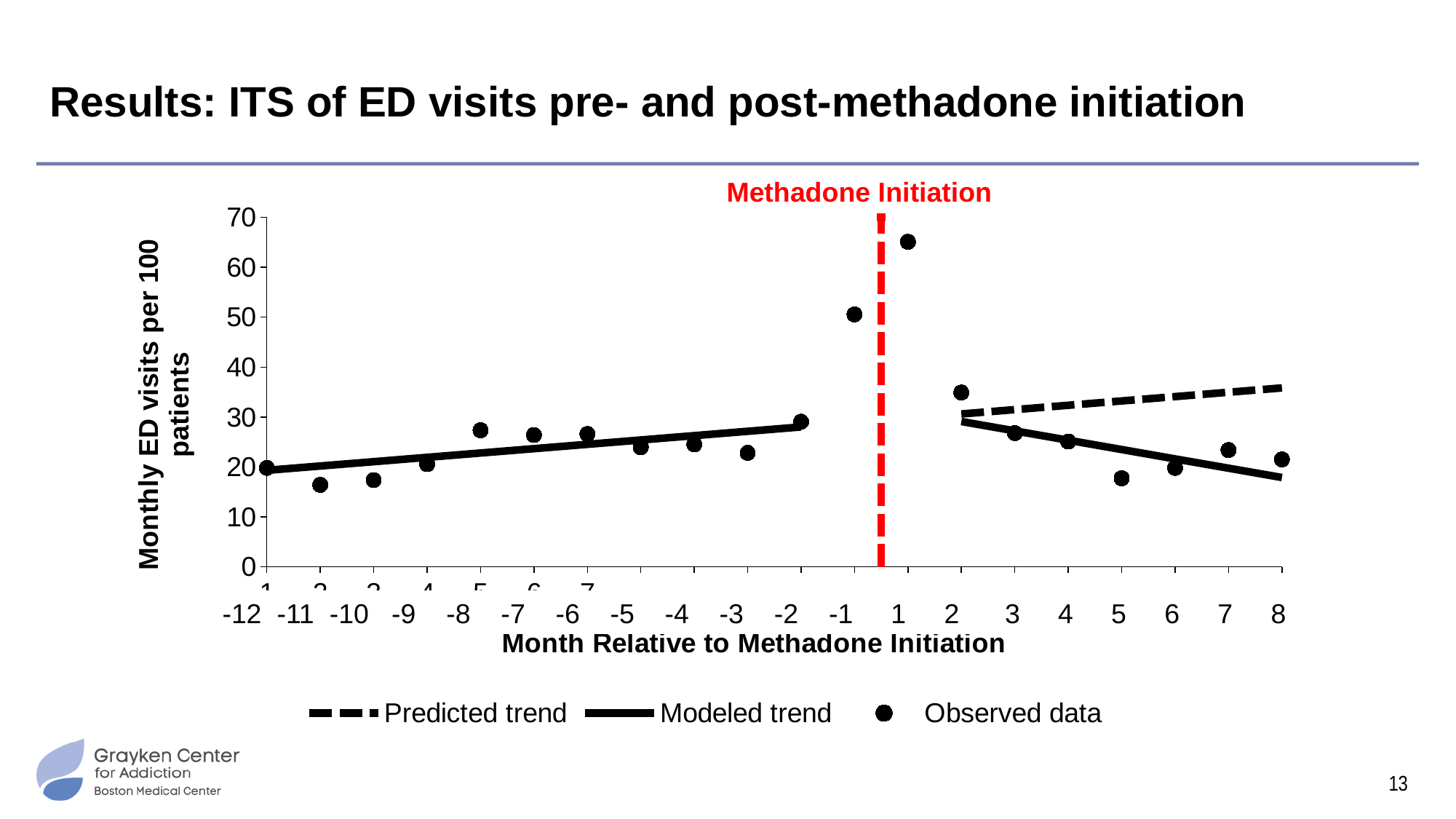
Is the observed value for month 2 greater or less than 30? greater How many entries does the legend list? 3 Is the observed value for month -1 greater or less than 40? greater How many observed data points are plotted? 20 At which month relative to methadone initiation is the observed value highest? 1 What kind of chart is shown on the slide? scatter chart What does the red dashed vertical line mark? Methadone Initiation Which has the larger observed value, month 2 or month 8? month 2 Is the observed value for month 1 greater or less than 60? greater Does the modeled trend line after methadone initiation rise or fall across months 2 to 8? fall Does the modeled trend line before methadone initiation rise or fall from month -12 to month -2? rise